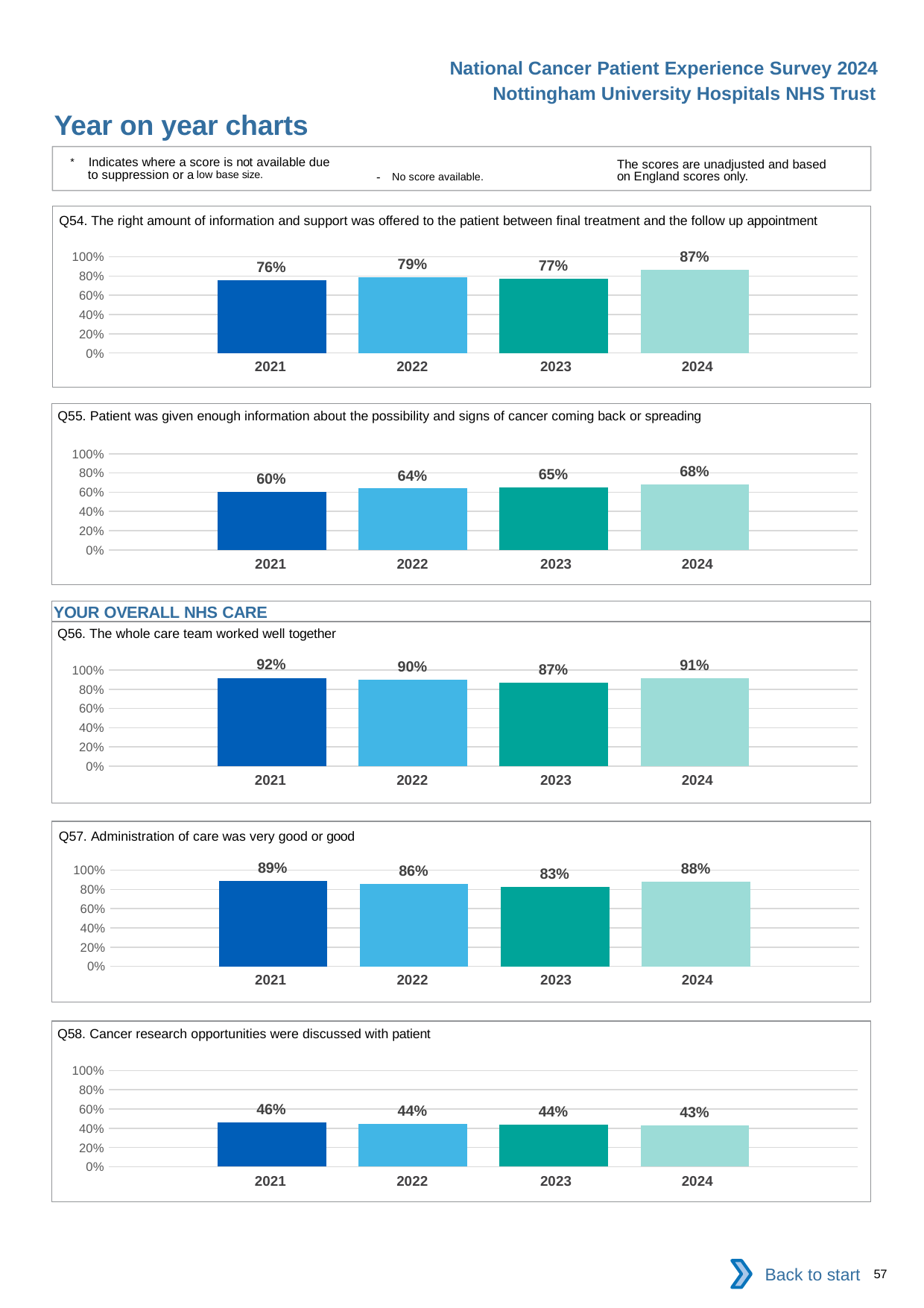
In the Q54 chart, what is the value for 2024? 87% In the Q55 chart, do the values rise or fall from 2021 to 2024? rise In the Q56 chart, what is the difference between the 2021 and 2023 values? 5% In the Q58 chart, is the value for 2021 greater or less than 60%? less How many bars are in the Q58 chart? 4 In the Q54 chart, which year has the highest value? 2024 In the Q57 chart, what is the value for 2021? 89% In the Q55 chart, which year has the lowest value? 2021 In the Q58 chart, what is the difference between the 2021 and 2024 values? 3% How many charts are shown on the slide? 5 What kind of chart is the Q55 chart? bar chart In the Q57 chart, which is larger, the value for 2022 or the value for 2023? 2022